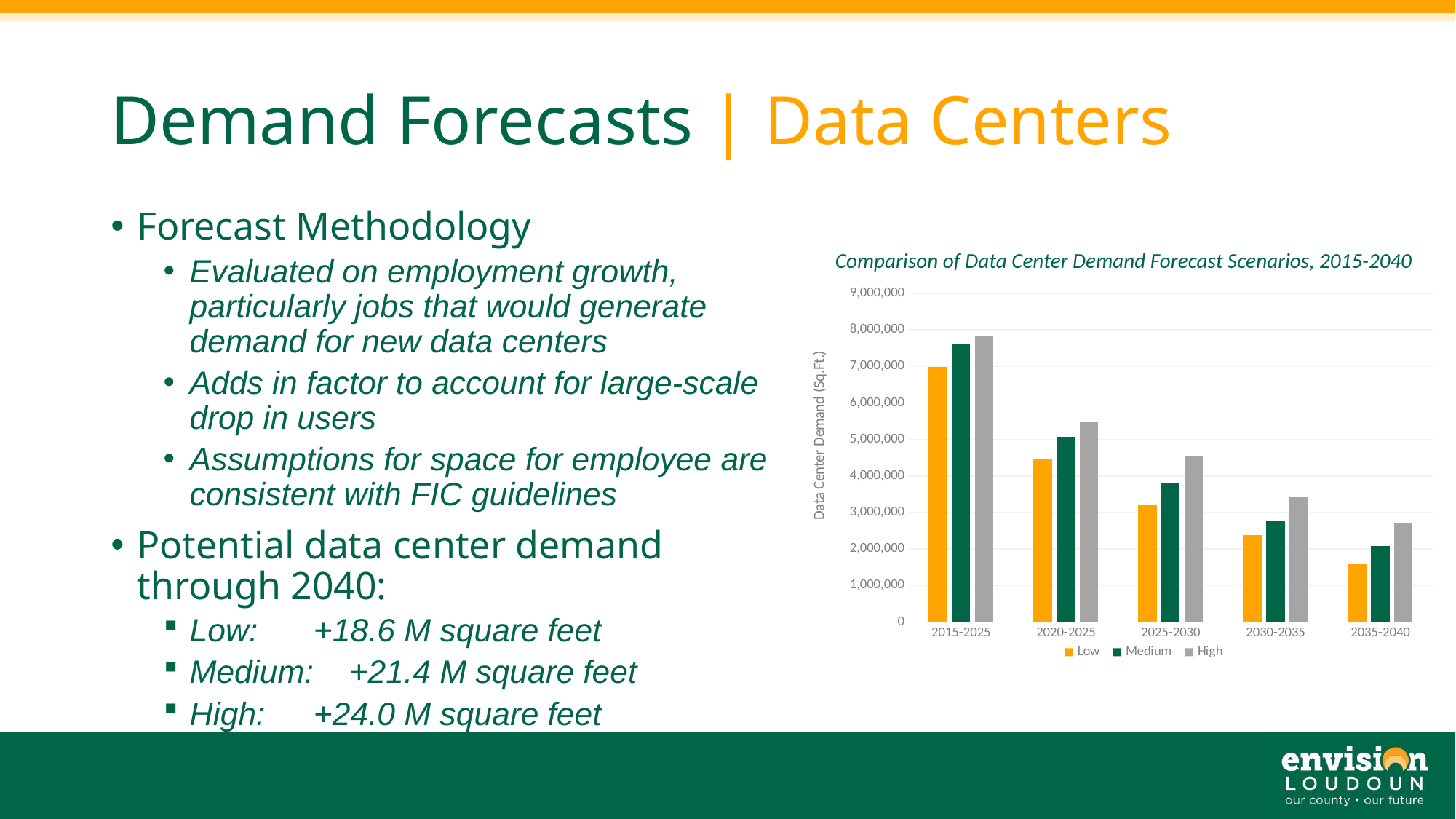
Do the Low scenario values rise or fall across the time periods from 2015-2025 to 2035-2040? fall How many series does the chart legend list? 3 Which time period has the highest High scenario value? 2015-2025 Is the Low scenario value for 2015-2025 greater or less than 6,000,000? greater What kind of chart is shown on the slide? bar chart What is the label on the y axis of the chart? Data Center Demand (Sq.Ft.) Which time period has the lowest Low scenario value? 2035-2040 Is the Low scenario value for 2035-2040 greater or less than 2,000,000? less Which is larger, the Medium scenario value for 2020-2025 or for 2025-2030? 2020-2025 How many time periods are shown on the x axis of the chart? 5 Is the High scenario value for 2020-2025 greater or less than 5,000,000? greater